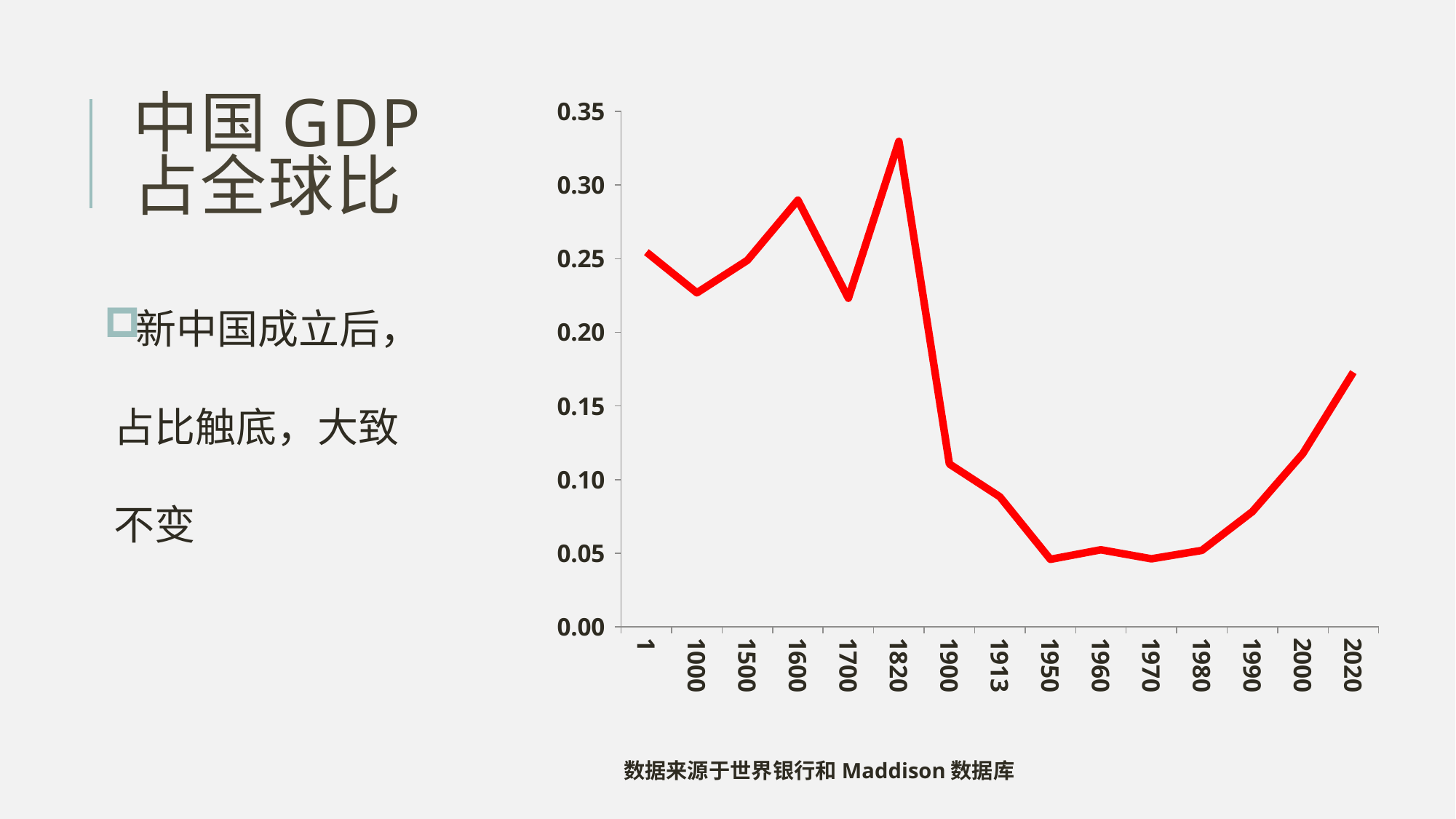
Is the value for 2020 greater or less than 0.15? greater What kind of chart is shown on the slide? line chart Do the values rise or fall along the x axis from 1980 to 2020? rise Is the value for 1820 greater or less than 0.30? greater What is the title of the chart on the slide? 中国 GDP 占全球比 Which is larger, the value for 1600 or the value for 1820? 1820 Is the value for 1700 greater or less than 0.25? less Which year on the x axis has the highest value in the chart? 1820 What colour is the line in the chart? red How many data points are plotted along the x axis of the chart? 15